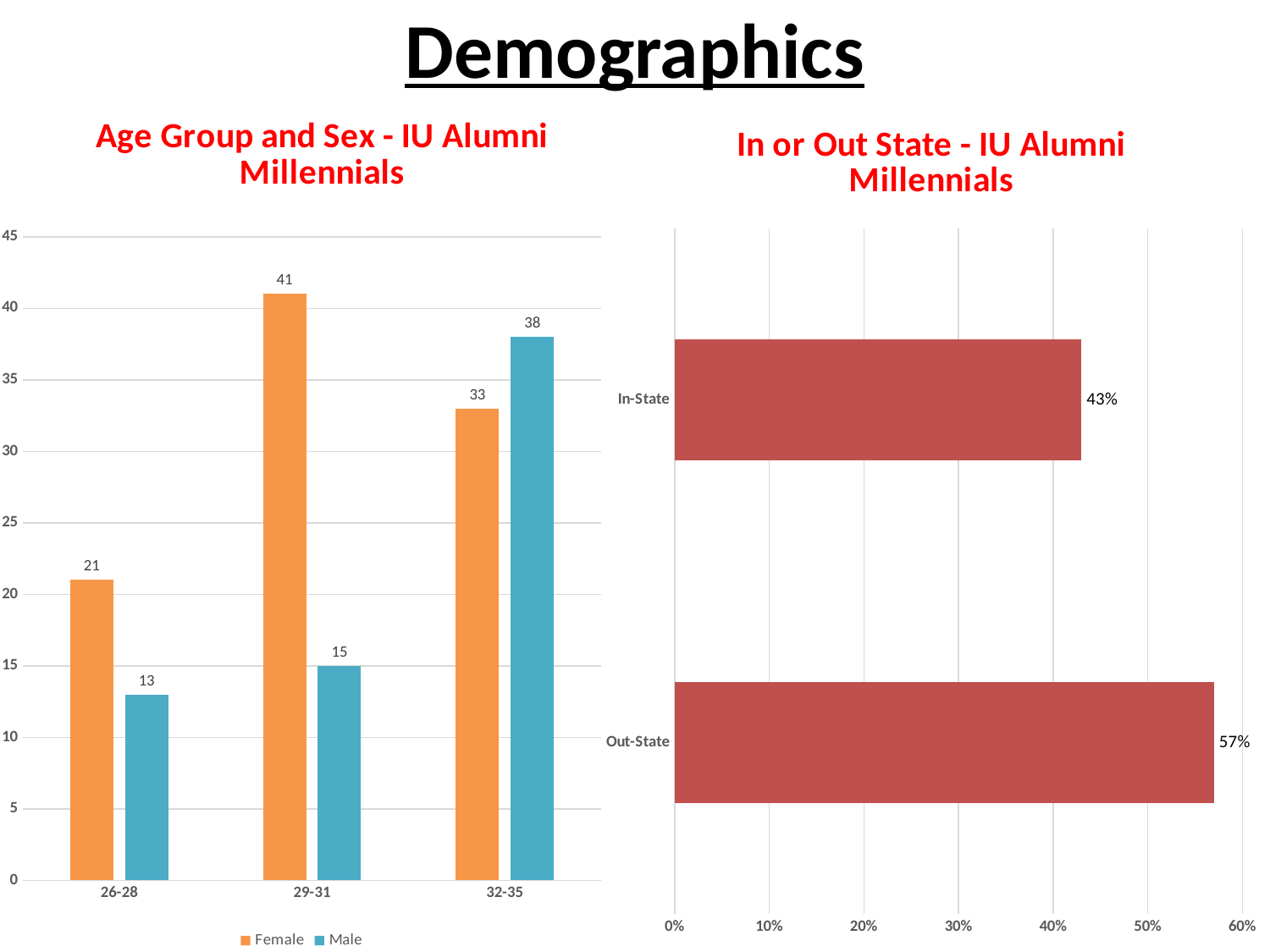
In the 'Age Group and Sex - IU Alumni Millennials' chart, which age group has the highest Male value? 32-35 In the 'In or Out State - IU Alumni Millennials' chart, what is the value for Out-State? 57% In the 'Age Group and Sex - IU Alumni Millennials' chart, what is the difference between the Female and Male values for the 29-31 age group? 26 In the 'Age Group and Sex - IU Alumni Millennials' chart, which is larger for the 32-35 age group, Female or Male? Male What kind of chart is the 'In or Out State - IU Alumni Millennials' chart? Bar chart In the 'Age Group and Sex - IU Alumni Millennials' chart, what is the Male value for the 26-28 age group? 13 In the 'Age Group and Sex - IU Alumni Millennials' chart, which age group has the lowest Female value? 26-28 How many age groups are shown in the 'Age Group and Sex - IU Alumni Millennials' chart? 3 In the 'Age Group and Sex - IU Alumni Millennials' chart, which colour represents the Female series? Orange In the 'Age Group and Sex - IU Alumni Millennials' chart, what is the Female value for the 29-31 age group? 41 How many series does the legend of the 'Age Group and Sex - IU Alumni Millennials' chart list? 2 In the 'In or Out State - IU Alumni Millennials' chart, which category has the higher value, In-State or Out-State? Out-State